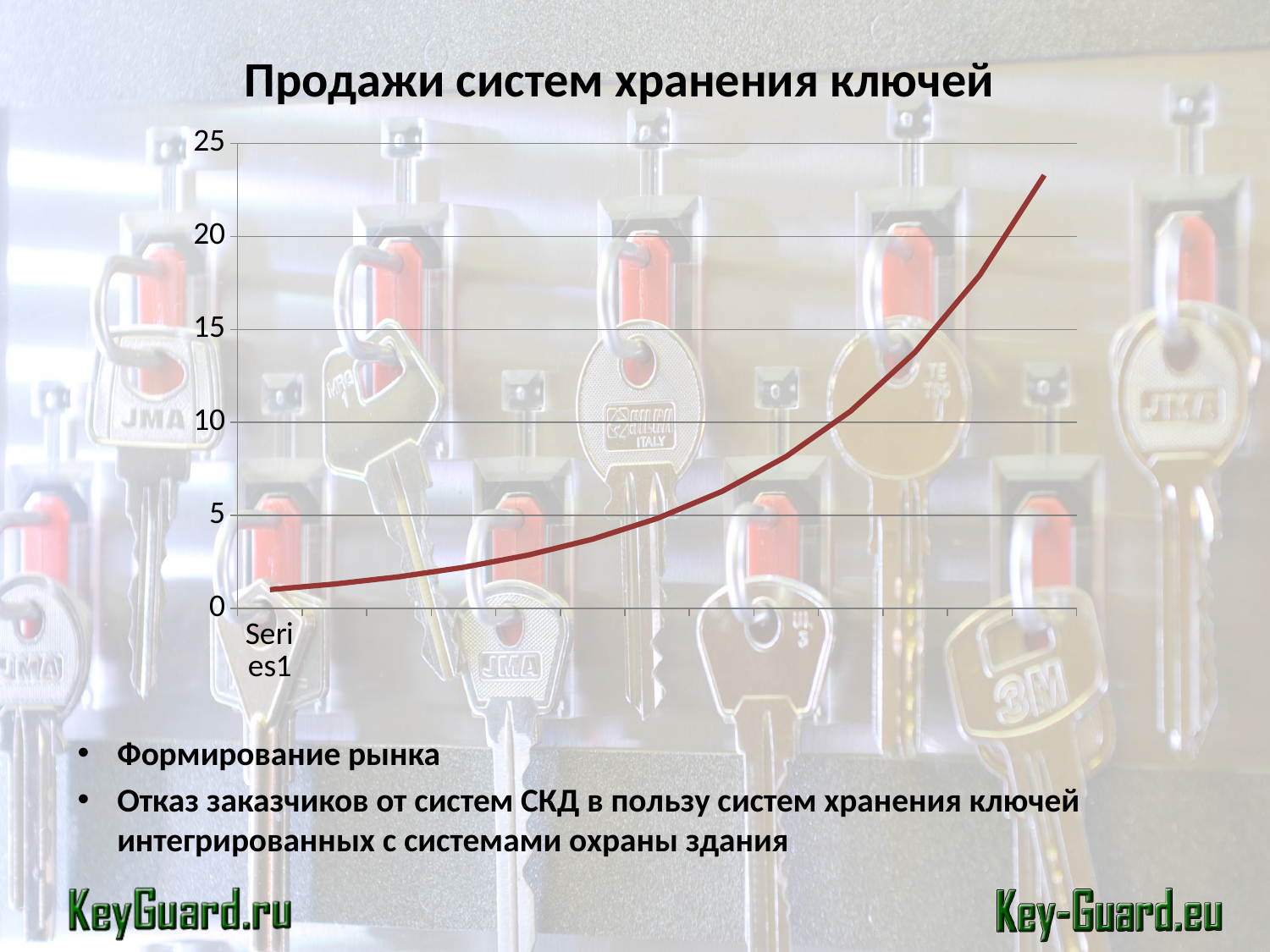
Which end of the line, left or right, has the larger value? right Is the value at the left end of the line greater or less than 5? less Is the value at the right end of the line greater or less than 25? less Is the value at the right end of the line greater or less than 20? greater What is the highest value shown on the y axis? 25 What label is shown on the x axis? Series1 Do the values on the chart rise or fall from left to right along the x axis? rise What kind of chart is shown on the slide? line chart What is the title of the chart? Продажи систем хранения ключей